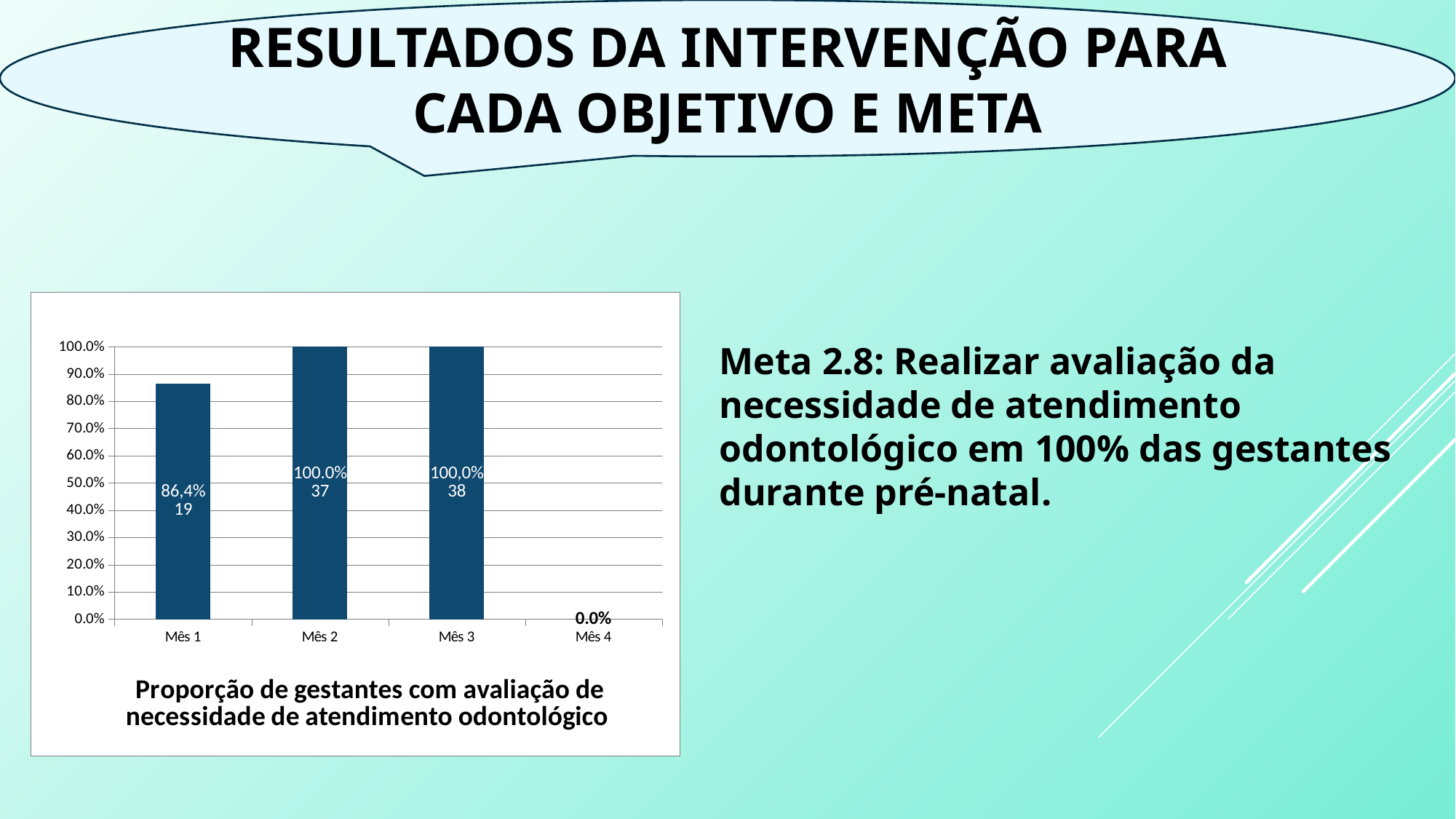
What is the value shown for Mês 2? 100.0% What is the value shown for Mês 1? 86,4% What is the title of the chart? Proporção de gestantes com avaliação de necessidade de atendimento odontológico How many months are shown on the x axis? 4 What is the difference between the count for Mês 3 and the count for Mês 2? 1 What count is printed inside the bar for Mês 3? 38 Which is larger, the value for Mês 1 or the value for Mês 2? Mês 2 Is the value for Mês 1 greater or less than 80.0%? greater What kind of chart is shown on the slide? Bar chart What count is printed inside the bar for Mês 1? 19 What is the value shown for Mês 4? 0.0% Which month has the lowest value? Mês 4